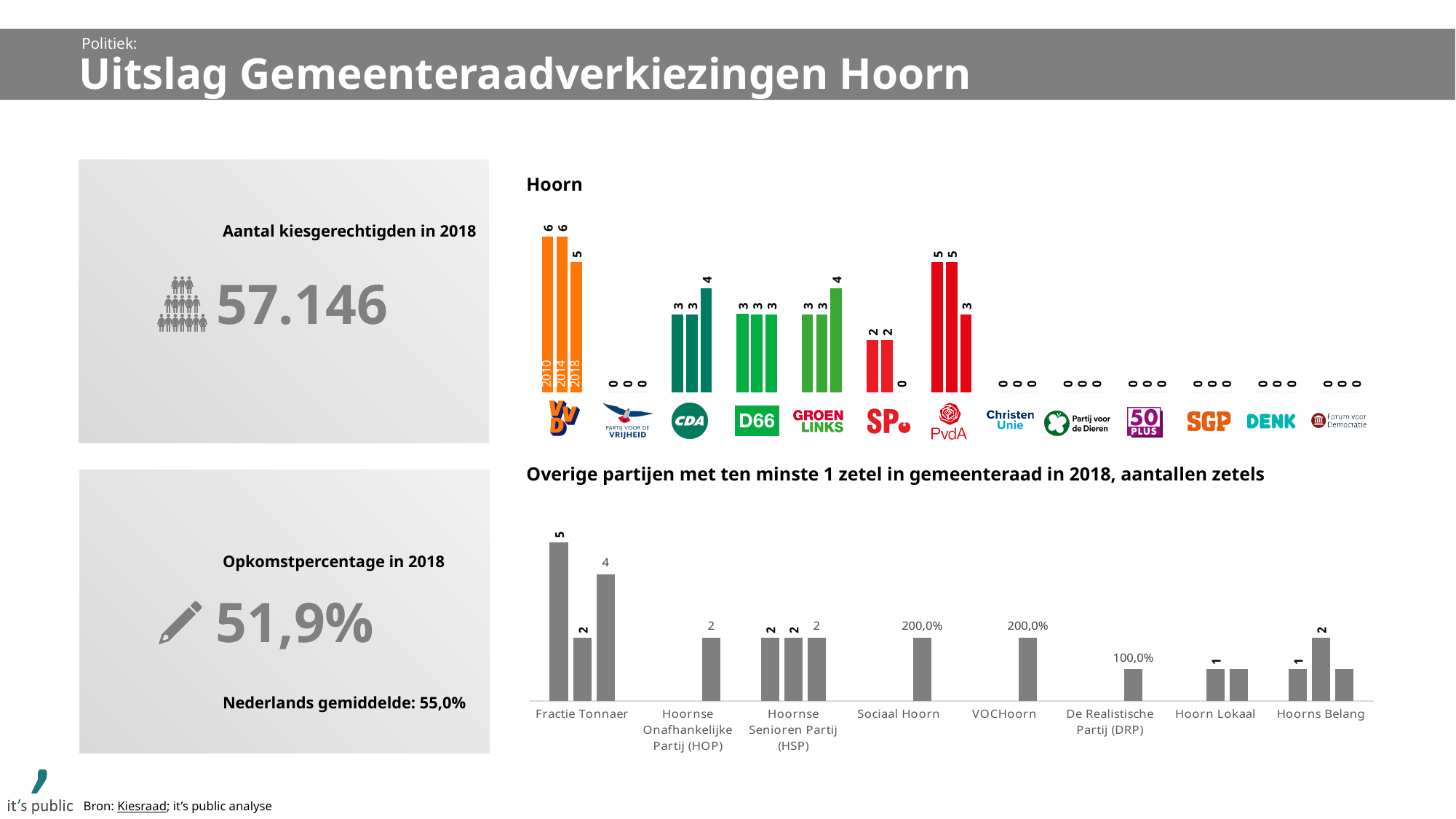
In the 'Overige partijen' chart, how many seats did Fractie Tonnaer have in its first bar? 5 In the 'Hoorn' chart, how many seats did the PvdA have in 2010? 5 In the 'Hoorn' chart, what is the difference between the PvdA's seats in 2014 and in 2018? 2 In the 'Overige partijen' chart, how many seats does the Hoornse Onafhankelijke Partij (HOP) have? 2 In the 'Hoorn' chart, which had more seats in 2018: D66 or GroenLinks? GroenLinks What type of chart is the 'Overige partijen' chart? bar chart In the 'Hoorn' chart, how many seats did the SP have in 2018? 0 In the 'Overige partijen' chart, how many party categories are shown on the x axis? 8 In the 'Hoorn' chart, which party had the most seats in 2018? VVD In the 'Hoorn' chart, how many years are shown per party? 3 In the 'Hoorn' chart, how many seats did the VVD have in 2018? 5 In the 'Hoorn' chart, did the CDA's seats rise or fall from 2014 to 2018? rise